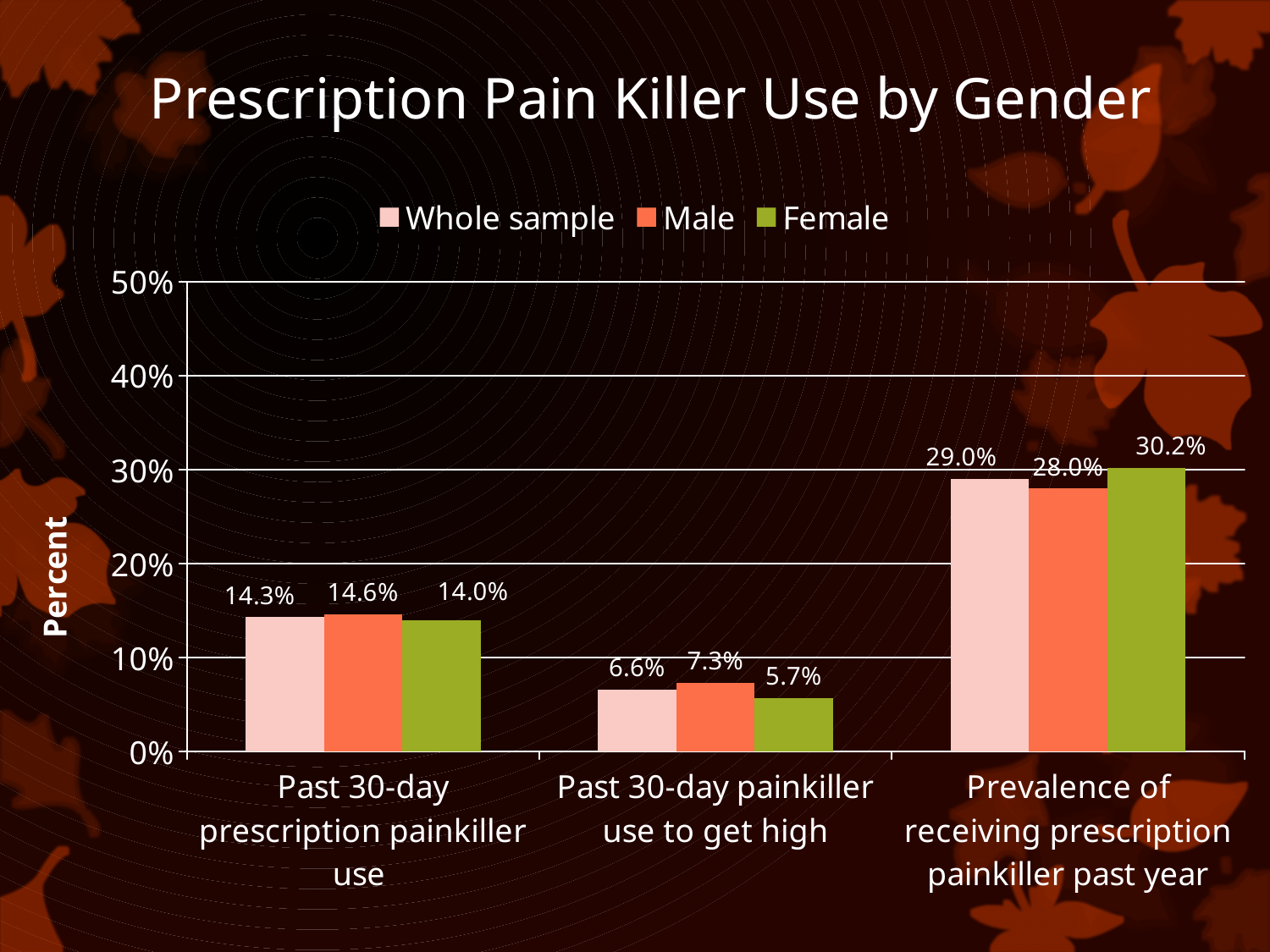
Is the Female value for Prevalence of receiving prescription painkiller past year greater or less than 30%? greater What is the difference between the Female and Male values for Prevalence of receiving prescription painkiller past year? 2.2% Which category has the lowest Whole sample value? Past 30-day painkiller use to get high What is the Male value for Past 30-day prescription painkiller use? 14.6% Which category has the highest Female value? Prevalence of receiving prescription painkiller past year How many categories are shown on the x axis? 3 What is the Whole sample value for Prevalence of receiving prescription painkiller past year? 29.0% For Past 30-day painkiller use to get high, which is larger: the Male value or the Female value? Male How many series does the legend list? 3 What is the title of the chart? Prescription Pain Killer Use by Gender What is the Female value for Past 30-day painkiller use to get high? 5.7% What kind of chart is shown on the slide? bar chart